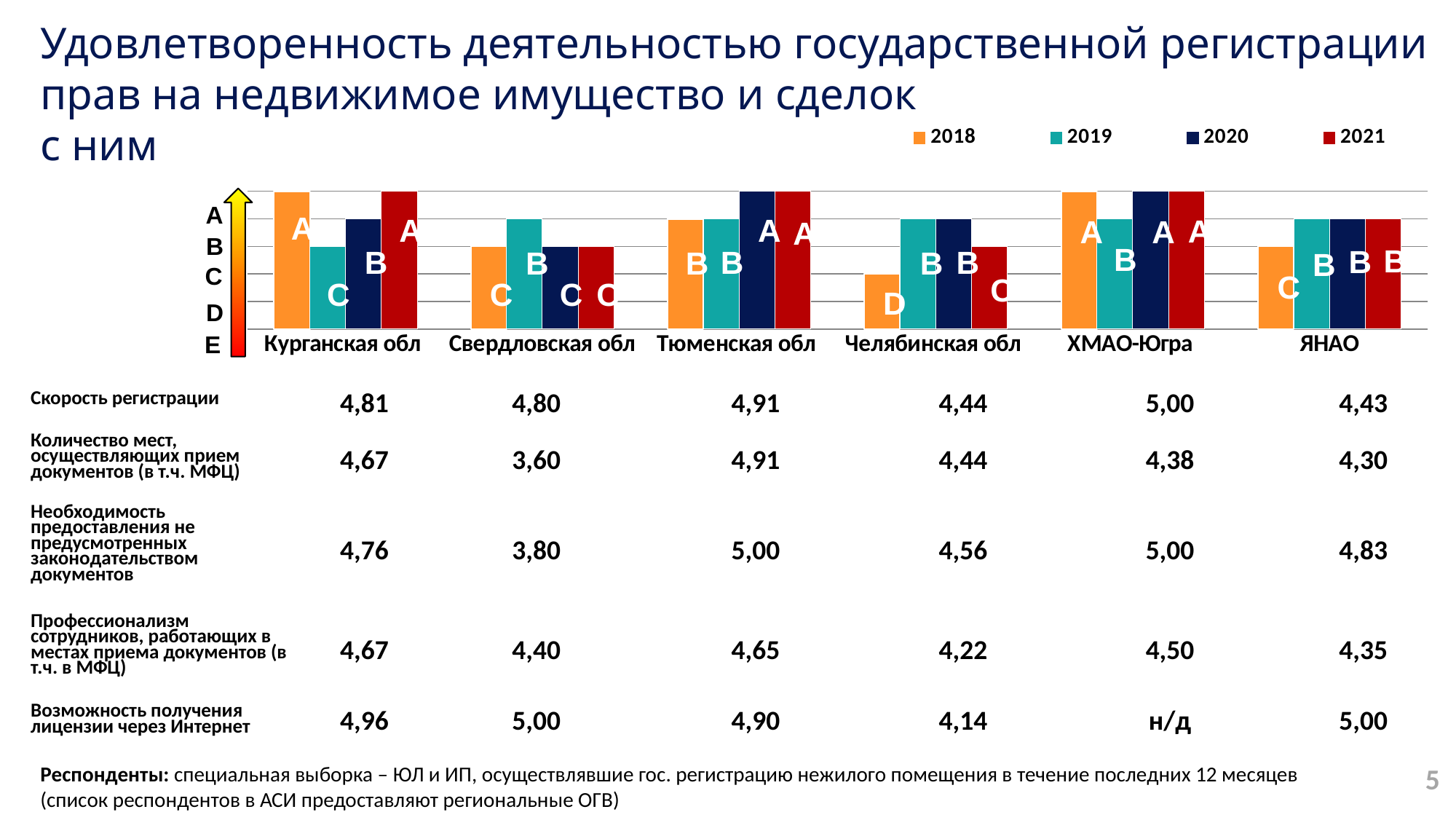
How many regions are shown along the x axis of the chart? 6 What grade is shown for Свердловская обл in 2021? C Which region has the lowest grade in 2018? Челябинская обл What grade is shown for Челябинская обл in 2018? D What grade is shown for Курганская обл in 2019? C Which region has the higher grade in 2021, Курганская обл or Свердловская обл? Курганская обл What grade is shown for ЯНАО in 2021? B What grade is shown for ХМАО-Югра in 2019? B Which colour represents the 2021 series in the chart legend? dark red What grade is shown for Тюменская обл in 2020? A What kind of chart is shown on the slide? bar chart How many series does the chart legend list? 4